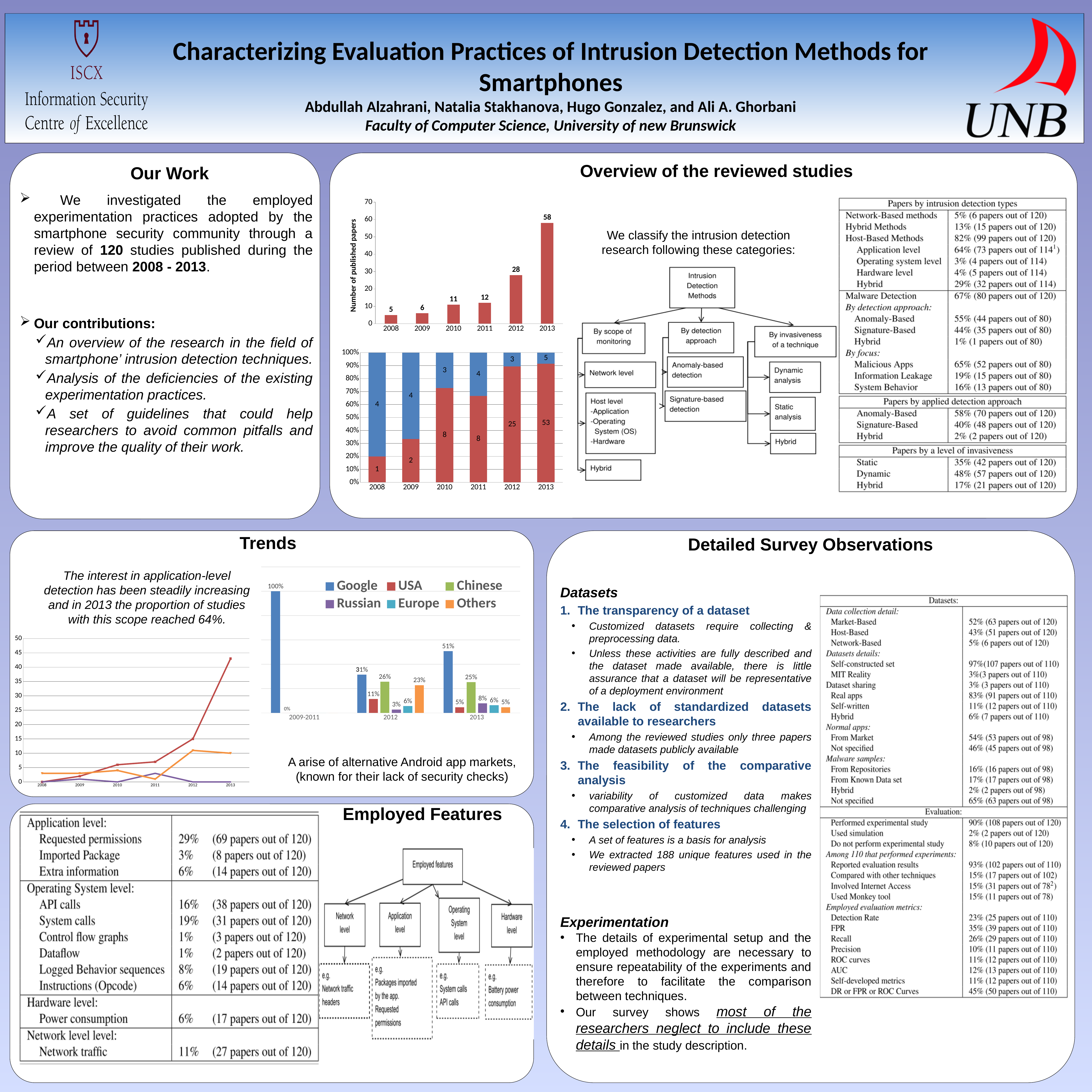
In the 'Number of published papers' bar chart in the Overview section, how many years are shown on the x axis? 6 In the 'Number of published papers' bar chart in the Overview section, do the values rise or fall from 2008 to 2013? rise In the 100% stacked bar chart in the Overview section, what is the total of the two segments for 2012? 28 In the Trends section bar chart with the Google/USA/Chinese legend, what is the value for Google in 2013? 51% In the 'Number of published papers' bar chart in the Overview section, which year has the lowest number of papers? 2008 In the 100% stacked bar chart in the Overview section, what is the value of the red segment for 2013? 53 In the 'Number of published papers' bar chart in the Overview section, what is the difference between the number of papers in 2013 and in 2012? 30 In the Trends section bar chart with the Google/USA/Chinese legend, how many series does the legend list? 6 What kind of chart is the 'Number of published papers' chart in the Overview section? bar chart In the 'Number of published papers' bar chart in the Overview section, which year has the highest number of papers? 2013 In the 'Number of published papers' bar chart in the Overview section, how many papers were published in 2010? 11 In the 'Number of published papers' bar chart in the Overview section, how many papers were published in 2013? 58